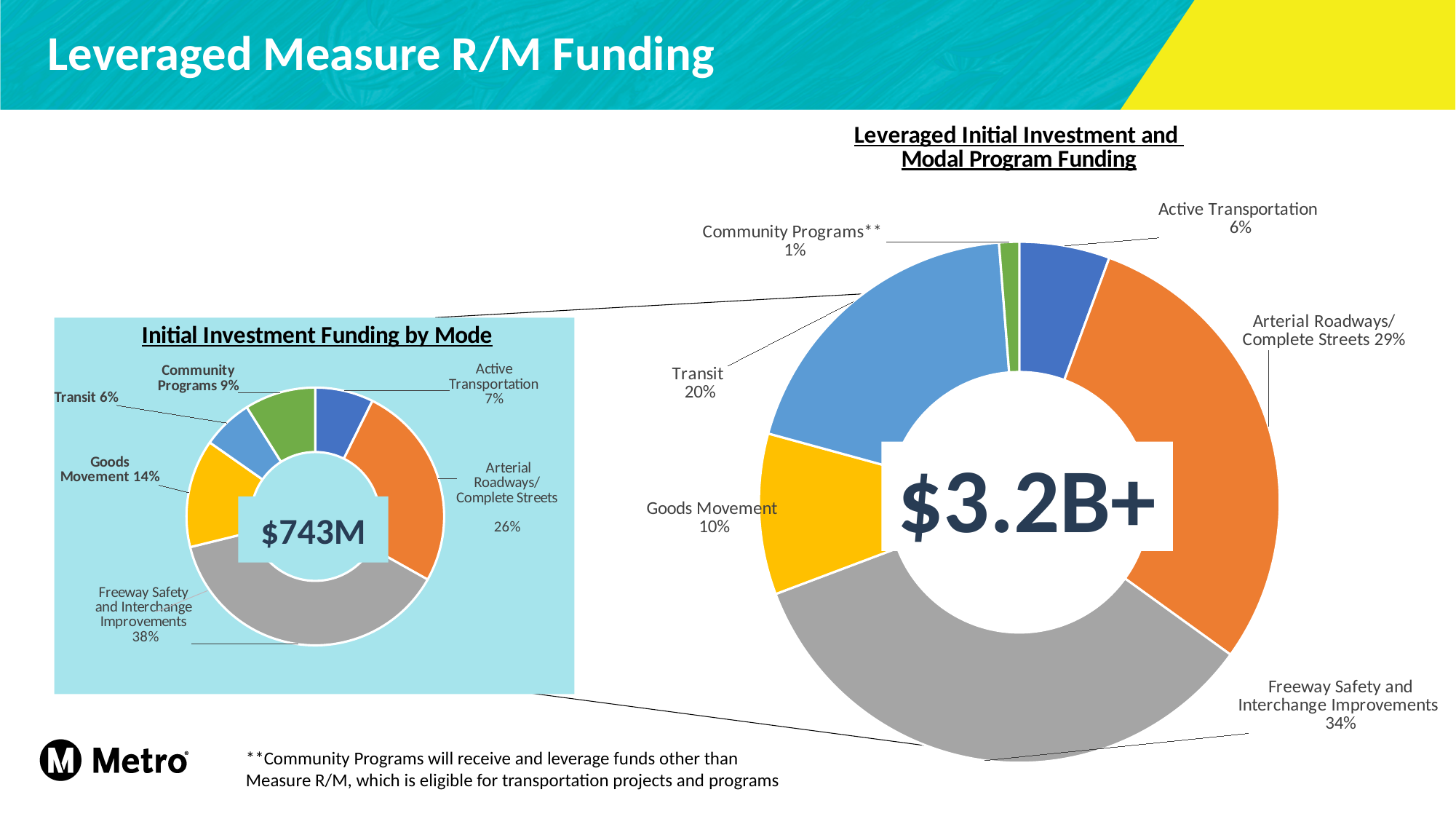
In the 'Leveraged Initial Investment and Modal Program Funding' chart, what is the difference between Transit and Goods Movement? 10% In the 'Initial Investment Funding by Mode' chart, what is the value for Goods Movement? 14% In the 'Leveraged Initial Investment and Modal Program Funding' chart, which category has the smallest share? Community Programs In the 'Initial Investment Funding by Mode' chart, what share does Freeway Safety and Interchange Improvements have? 38% In the 'Initial Investment Funding by Mode' chart, what total is shown in the centre of the donut? $743M In the 'Leveraged Initial Investment and Modal Program Funding' chart, what total is shown in the centre of the donut? $3.2B+ What kind of chart is the 'Initial Investment Funding by Mode' chart? Donut (pie) chart How many categories does the 'Leveraged Initial Investment and Modal Program Funding' chart show? 6 In the 'Leveraged Initial Investment and Modal Program Funding' chart, which is larger, Transit or Active Transportation? Transit In the 'Leveraged Initial Investment and Modal Program Funding' chart, what share does Arterial Roadways/Complete Streets have? 29% In the 'Initial Investment Funding by Mode' chart, which category has the smallest share? Transit In the 'Leveraged Initial Investment and Modal Program Funding' chart, which category has the largest share? Freeway Safety and Interchange Improvements